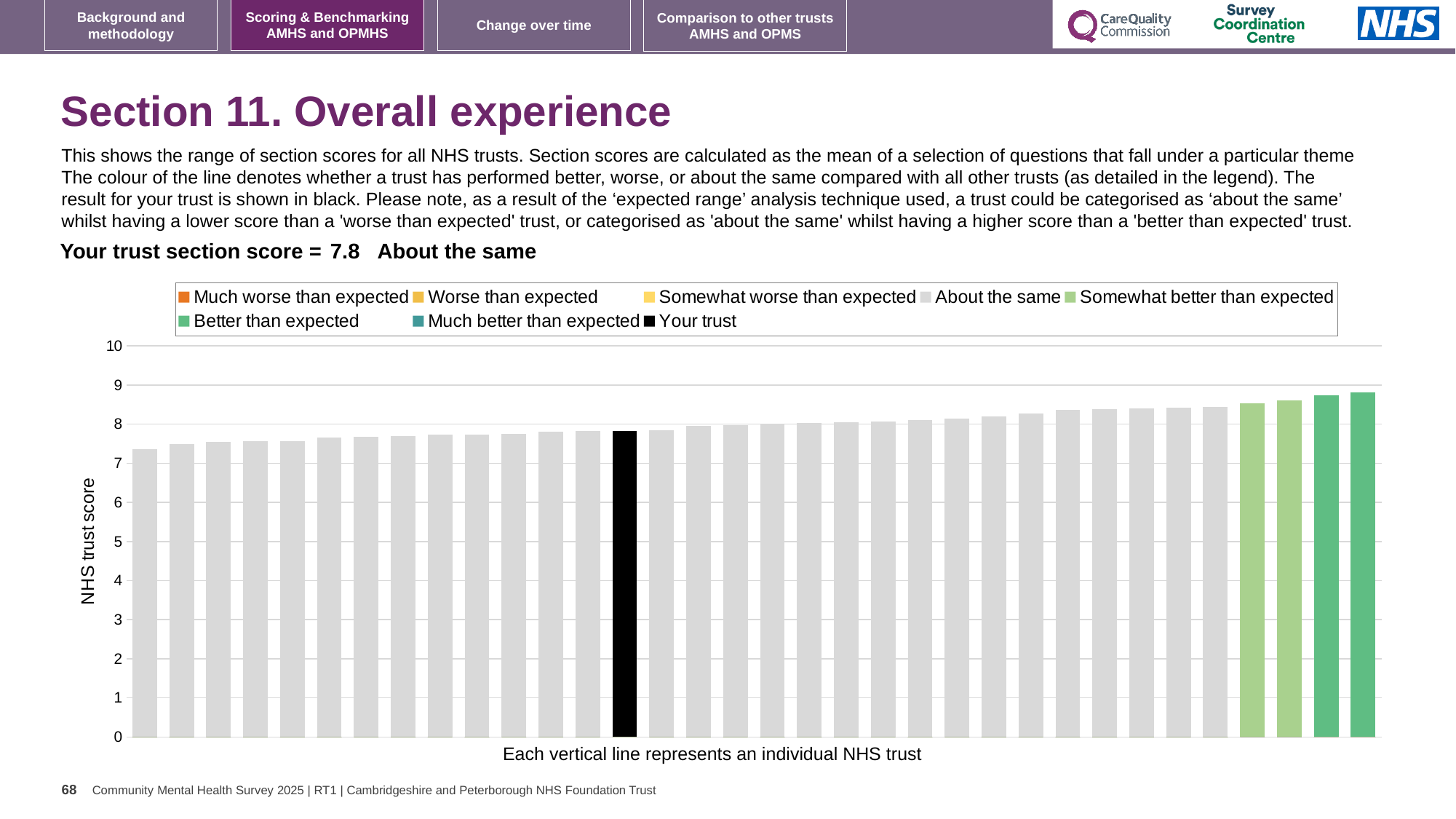
What is the label on the vertical axis of the chart? NHS trust score How many bars in the chart are coloured green (somewhat better or better than expected)? 4 What colour is the bar representing your trust? black Is the value of the lowest bar in the chart greater or less than 7? greater What kind of chart is shown on the slide? bar chart Do the bar values rise or fall from left to right along the x axis? rise Which category is your trust's section score placed in? About the same Is the value for the black 'Your trust' bar greater or less than 7? greater What is the maximum value shown on the vertical axis? 10 Is the value of the highest bar in the chart greater or less than 9? less How many entries does the chart legend list? 8 What is the section score for your trust shown on the slide? 7.8